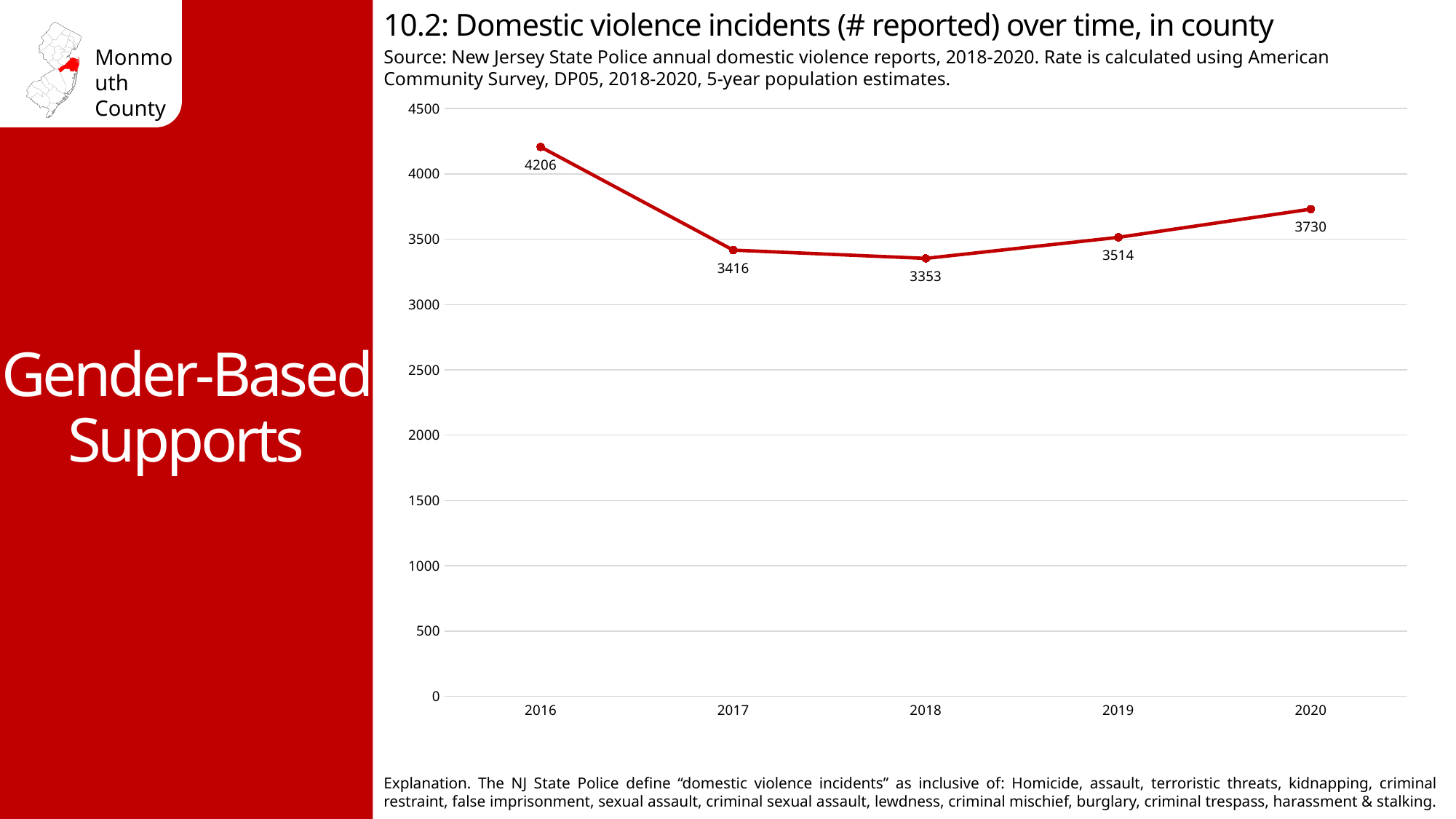
What is the difference between the 2016 value and the 2017 value? 790 Which year has a larger value, 2017 or 2019? 2019 Do the values rise or fall from 2018 to 2020? rise Is the value for 2016 greater or less than 4000? greater By how much did the number of incidents increase from 2019 to 2020? 216 What kind of chart is shown on the slide? line chart Which year has the highest number of reported domestic violence incidents? 2016 What is the value plotted for 2020? 3730 How many years are plotted on the x axis? 5 How many domestic violence incidents were reported in 2016? 4206 Which year has the lowest number of reported domestic violence incidents? 2018 What is the value plotted for 2018? 3353